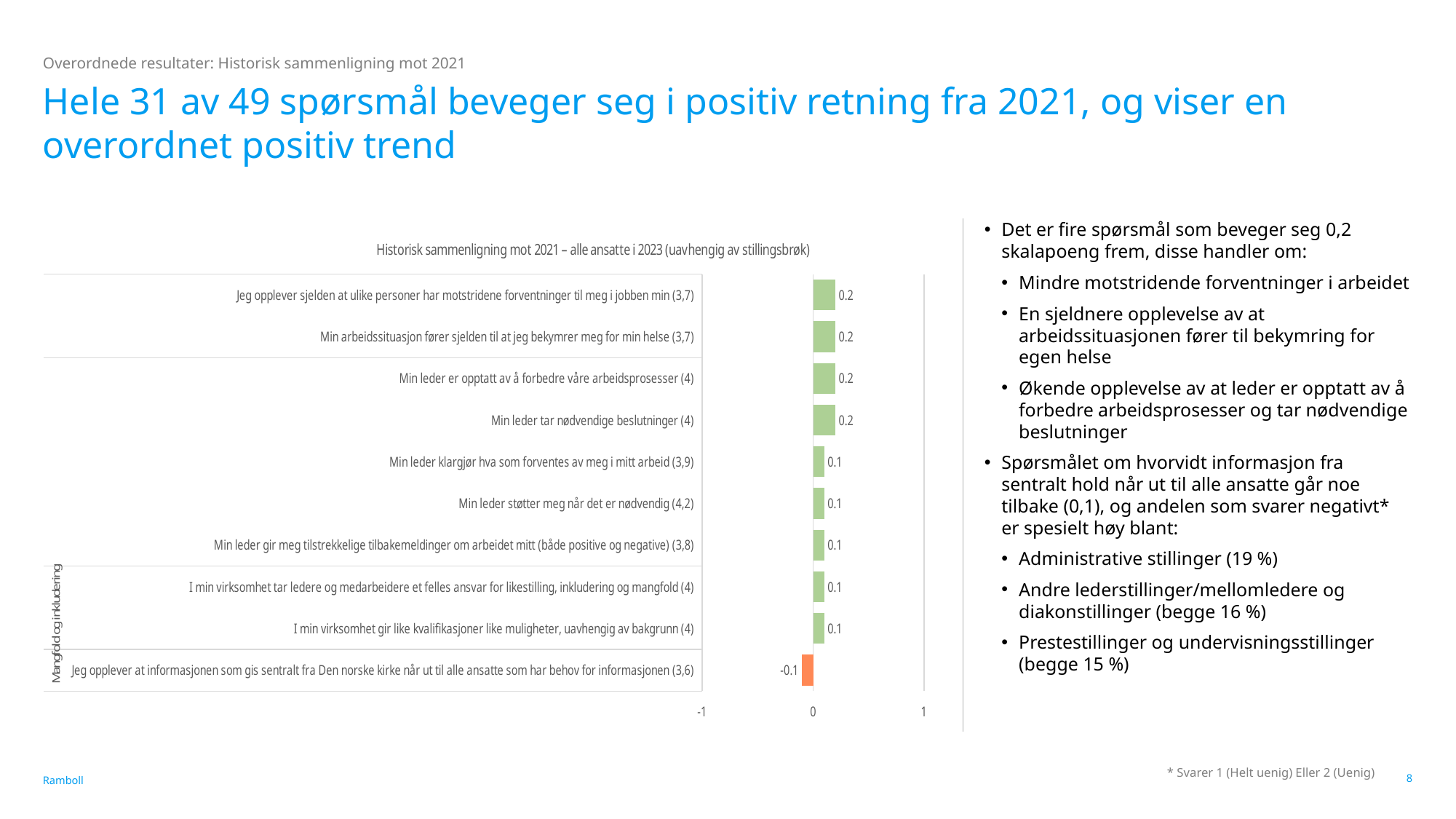
Is the value for "Jeg opplever sjelden at ulike personer har motstridene forventninger til meg i jobben min (3,7)" greater or less than 0? greater What is the difference between the value for "Min leder er opptatt av å forbedre våre arbeidsprosesser (4)" and the value for "Min leder klargjør hva som forventes av meg i mitt arbeid (3,9)"? 0.1 What is the value for "Min leder tar nødvendige beslutninger (4)"? 0.2 How many categories (questions) are plotted in the chart? 10 What type of chart is shown on the slide? Bar chart How many categories in the chart have a value of 0.2? 4 What is the title of the chart? Historisk sammenligning mot 2021 – alle ansatte i 2023 (uavhengig av stillingsbrøk) Which is larger: the value for "Min arbeidssituasjon fører sjelden til at jeg bekymrer meg for min helse (3,7)" or the value for "I min virksomhet gir like kvalifikasjoner like muligheter, uavhengig av bakgrunn (4)"? Min arbeidssituasjon fører sjelden til at jeg bekymrer meg for min helse (3,7) What colour is the bar for the only category with a negative value? Orange What is the value for "Min leder støtter meg når det er nødvendig (4,2)"? 0.1 What is the value for "Jeg opplever at informasjonen som gis sentralt fra Den norske kirke når ut til alle ansatte som har behov for informasjonen (3,6)"? -0.1 Which category has the lowest value in the chart? Jeg opplever at informasjonen som gis sentralt fra Den norske kirke når ut til alle ansatte som har behov for informasjonen (3,6)